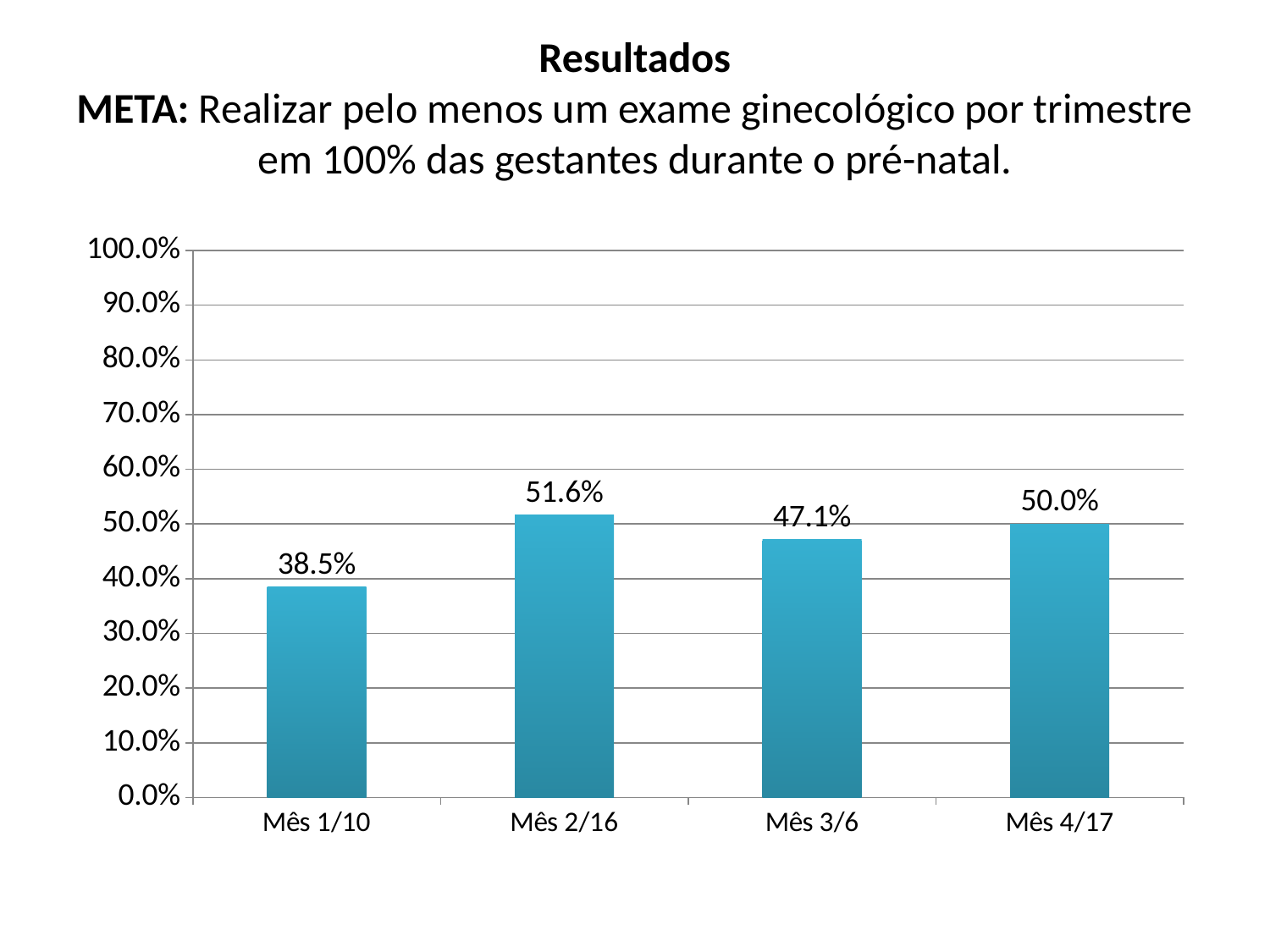
What is the value for Mês 3/6? 47.1% Is the value for Mês 1/10 greater or less than 40.0%? less Which is larger, the value for Mês 3/6 or the value for Mês 4/17? Mês 4/17 What kind of chart is shown on the slide? bar chart What is the value for Mês 1/10? 38.5% How many categories are shown on the x axis? 4 Which category has the lowest value? Mês 1/10 What is the difference between the values for Mês 2/16 and Mês 1/10? 13.1% Which category has the highest value? Mês 2/16 What is the value for Mês 2/16? 51.6% What is the value for Mês 4/17? 50.0% What is the maximum value shown on the y axis? 100.0%